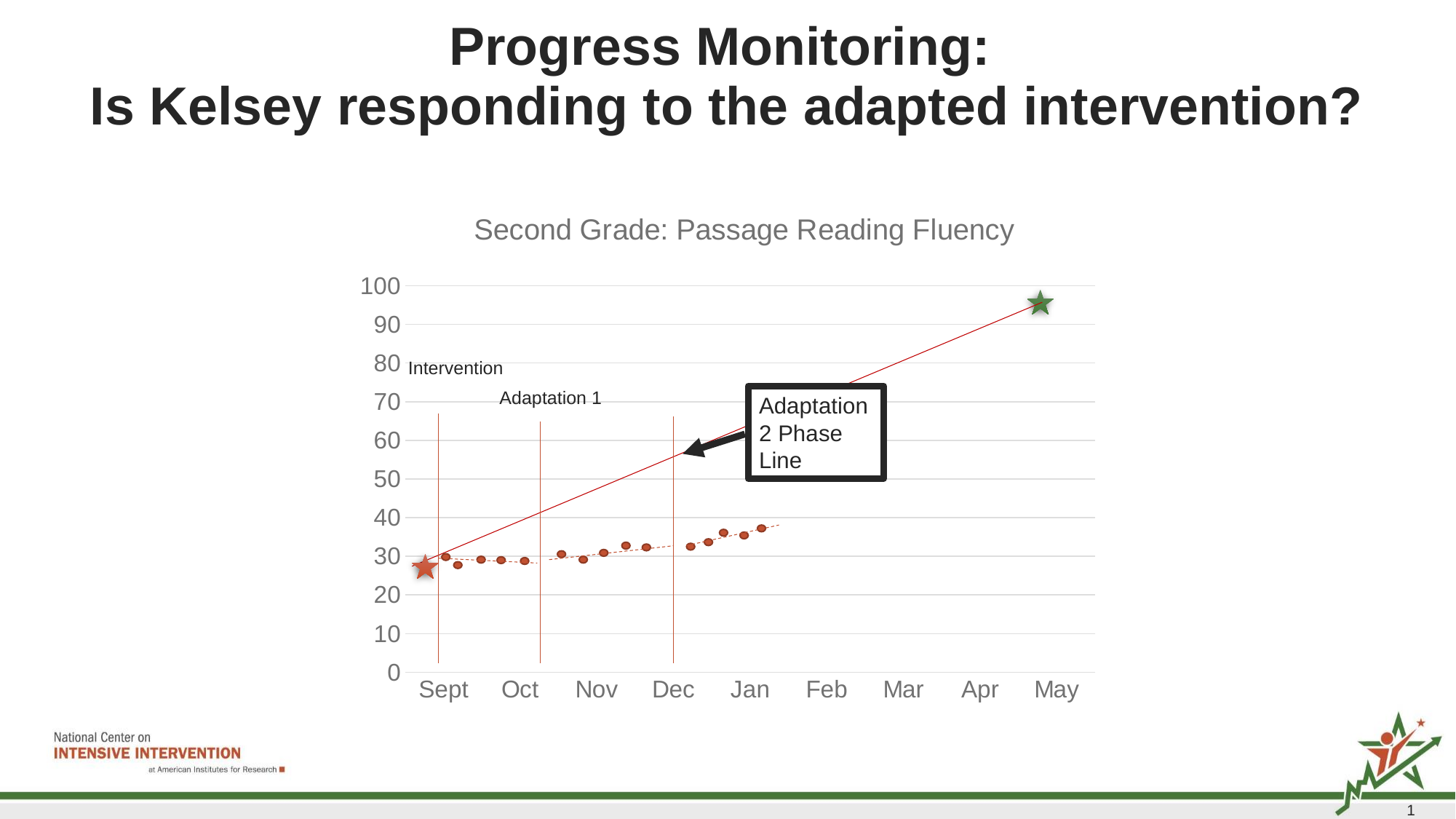
Which is larger, the green star goal point in May or the red star starting point in Sept? the green star goal point in May How many months are labelled on the x axis of the chart? 9 Are Kelsey's plotted data points in January greater or less than 40? less What is the first month labelled on the x axis? Sept How many vertical phase lines are drawn on the chart? 3 Do Kelsey's plotted data points rise or fall from Sept to Jan? rise What is the title of the chart? Second Grade: Passage Reading Fluency What kind of chart is shown on the slide? line chart Is the value of the red star starting point in Sept greater or less than 30? less What is the highest value shown on the y axis? 100 Are Kelsey's plotted data points in October greater or less than 50? less